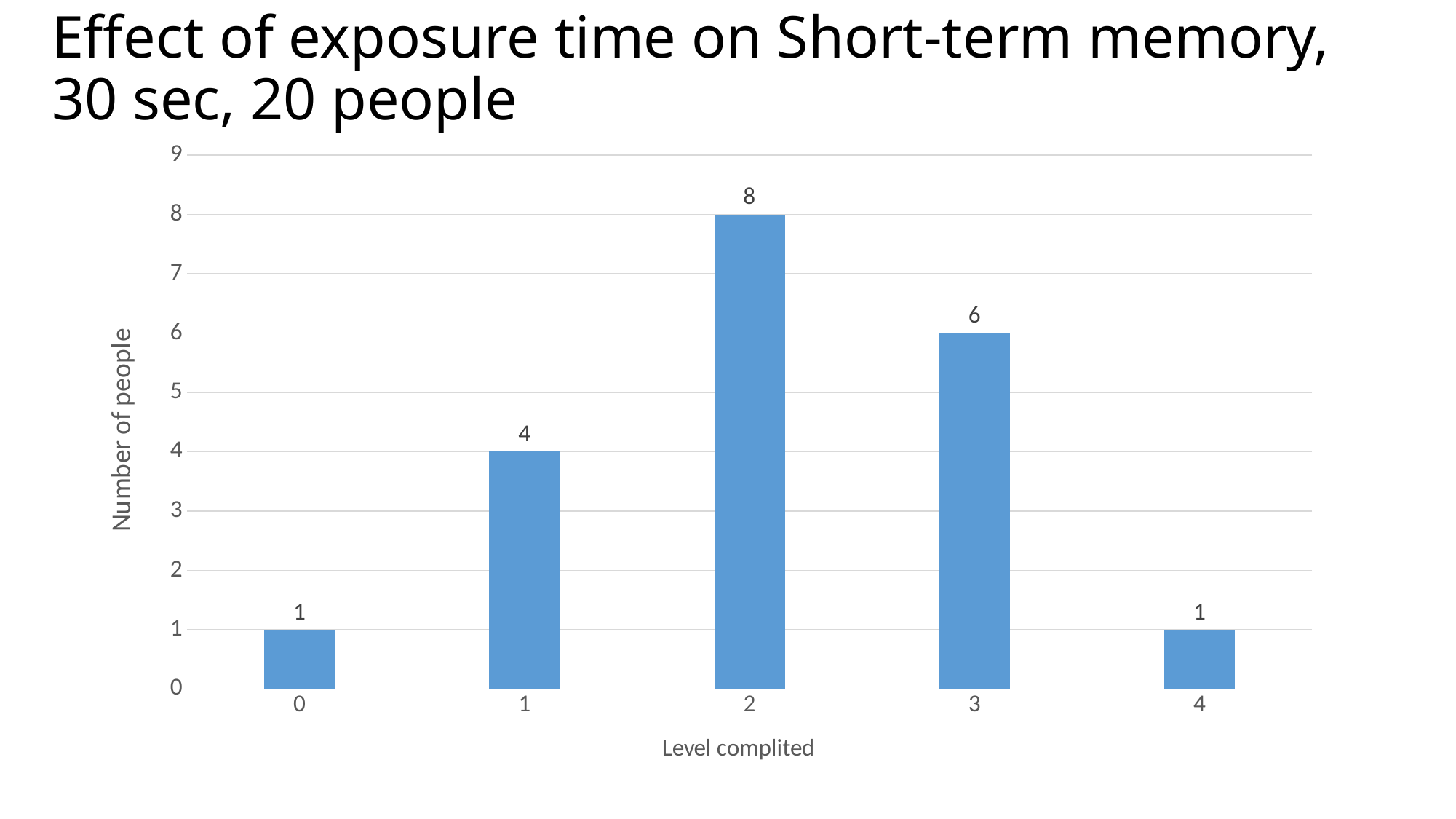
How many people completed level 3? 6 Which has more people, level 1 or level 3? Level 3 What kind of chart is shown on the slide? Bar chart What is the difference in number of people between level 1 and level 0? 3 What is the difference in number of people between level 2 and level 3? 2 How many level categories are shown on the x axis? 5 How many people completed level 1? 4 Which level completed has the highest number of people? 2 What is the label of the x axis? Level complited How many people completed level 2? 8 What is the label of the y axis? Number of people Is the number of people for level 2 greater or less than 7? greater